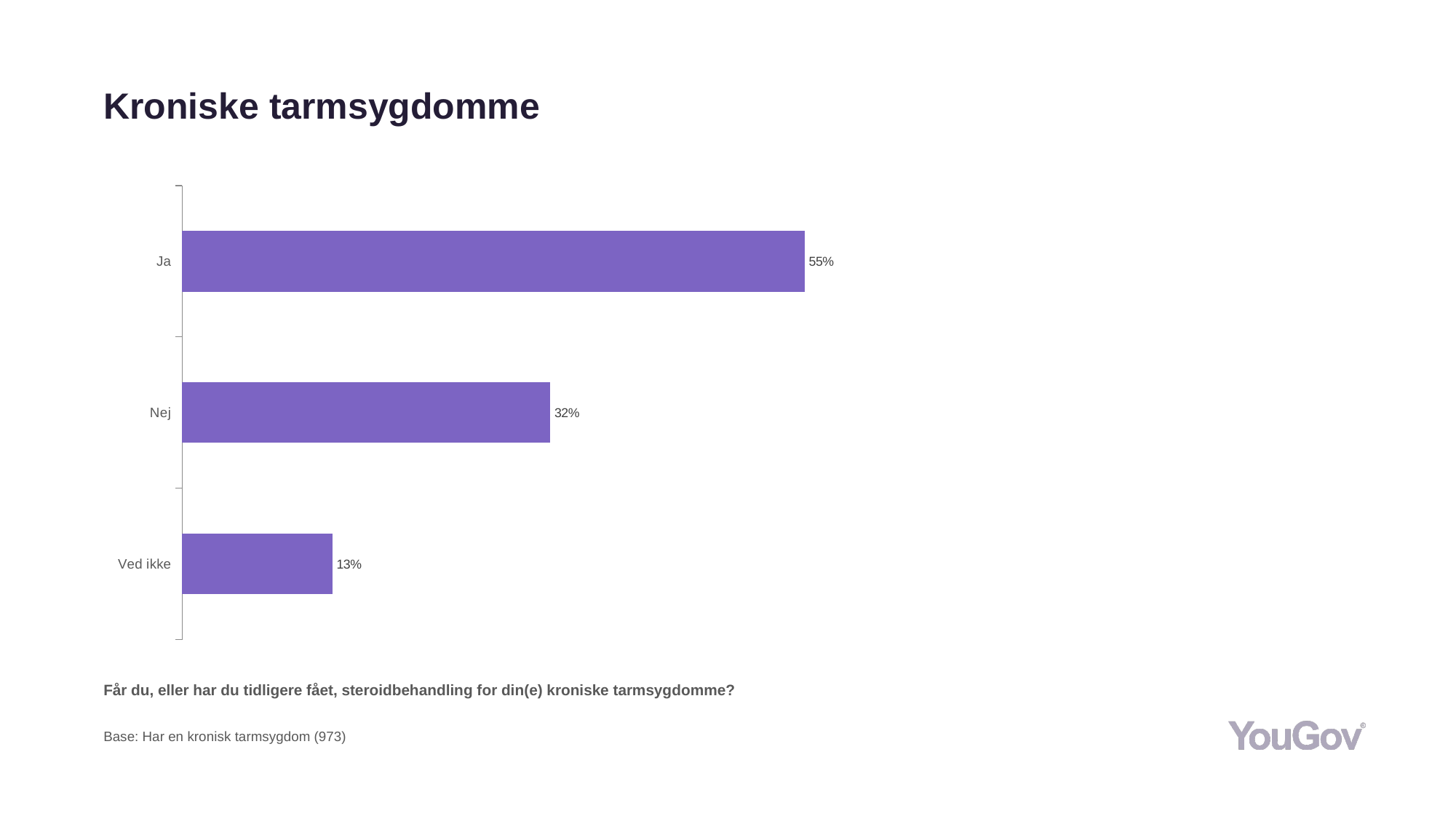
What is the difference between the values for "Ja" and "Nej"? 23% What is the value for "Nej"? 32% What is the difference between the values for "Nej" and "Ved ikke"? 19% What is the value for "Ved ikke"? 13% How many categories are shown in the chart? 3 Which category has the lowest value? Ved ikke What is the value for "Ja"? 55% Which is larger, the value for "Nej" or the value for "Ved ikke"? Nej What is the title of the slide? Kroniske tarmsygdomme What kind of chart is shown on the slide? Bar chart What is the base size stated below the chart? 973 Which category has the highest value? Ja